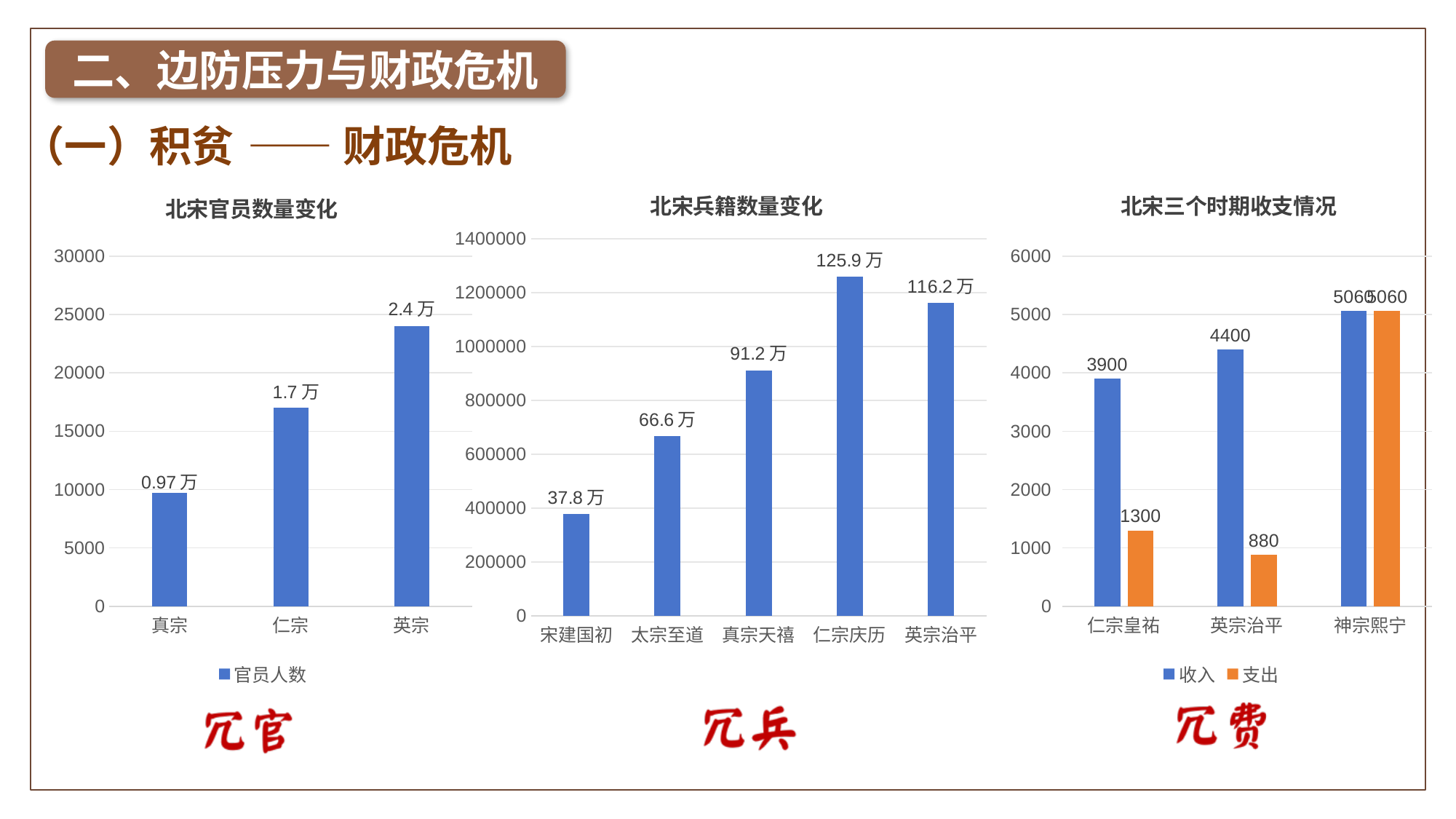
In the chart titled 北宋三个时期收支情况, what is the difference between 收入 and 支出 for 仁宗皇祐? 2600 In the chart titled 北宋官员数量变化, do the values rise or fall from 真宗 to 英宗? rise In the chart titled 北宋三个时期收支情况, how many series does the legend list? 2 In the chart titled 北宋官员数量变化, which category has the highest value? 英宗 In the chart titled 北宋兵籍数量变化, how many bars are plotted? 5 In the chart titled 北宋兵籍数量变化, which is larger, 仁宗庆历 or 英宗治平? 仁宗庆历 In the chart titled 北宋兵籍数量变化, which category has the lowest value? 宋建国初 In the chart titled 北宋兵籍数量变化, what is the value for 太宗至道? 66.6 万 In the chart titled 北宋官员数量变化, how many categories are shown on the x axis? 3 In the chart titled 北宋官员数量变化, what is the value for 仁宗? 1.7 万 In the chart titled 北宋三个时期收支情况, what is the 支出 value for 英宗治平? 880 What kind of chart is the chart titled 北宋三个时期收支情况? bar chart